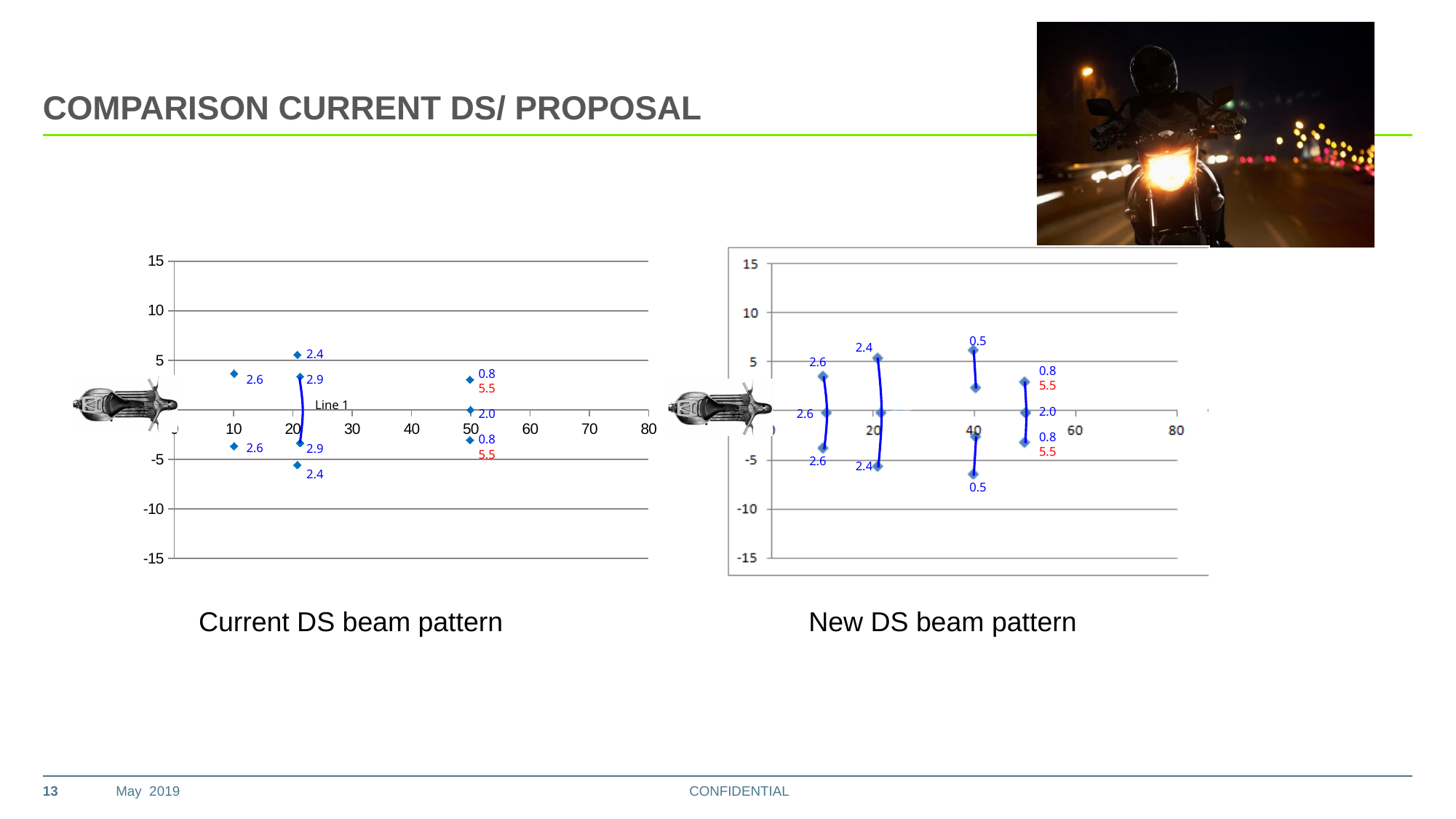
In the Current DS beam pattern chart, what is the difference between the 2.9 label and the 2.4 label on the points near x = 20? 0.5 In the Current DS beam pattern chart, what data label is shown on the topmost point near x = 20? 2.4 In the Current DS beam pattern chart, what data label is shown on the point at x = 50 lying on the horizontal axis? 2.0 In the New DS beam pattern chart, what red data label is shown next to the points near x = 50? 5.5 In the New DS beam pattern chart, is the topmost point near x = 40 greater or less than 5 on the vertical axis? greater In the New DS beam pattern chart, what data label is shown on the points near x = 40? 0.5 What is the highest value shown on the horizontal axis of the New DS beam pattern chart? 80 In the Current DS beam pattern chart, what data label is shown on the points near x = 10? 2.6 What kind of chart is the New DS beam pattern chart? scatter chart In the New DS beam pattern chart, what data label is shown on the points near x = 20? 2.4 What kind of chart is the Current DS beam pattern chart? scatter chart